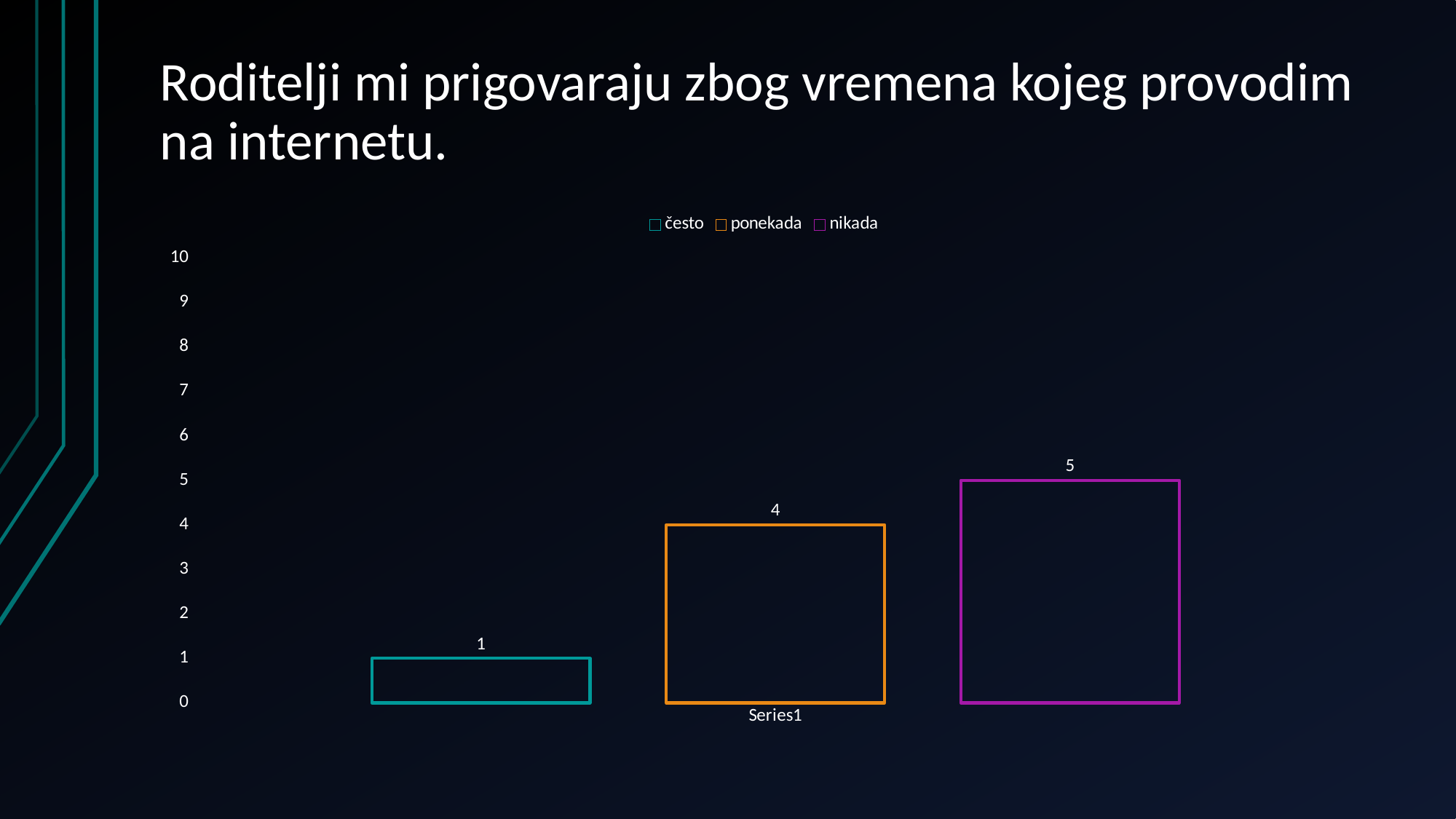
What is the value for "ponekada"? 4 How many series does the legend list? 3 Which is larger, the value for "ponekada" or the value for "nikada"? nikada What is the value for "nikada"? 5 What is the highest value shown on the vertical axis? 10 What is the value for "često"? 1 What kind of chart is shown on the slide? bar chart Which series has the highest value? nikada What is the category label shown below the bars? Series1 Which series has the lowest value? često What is the difference between the values for "ponekada" and "često"? 3 What is the difference between the values for "nikada" and "često"? 4